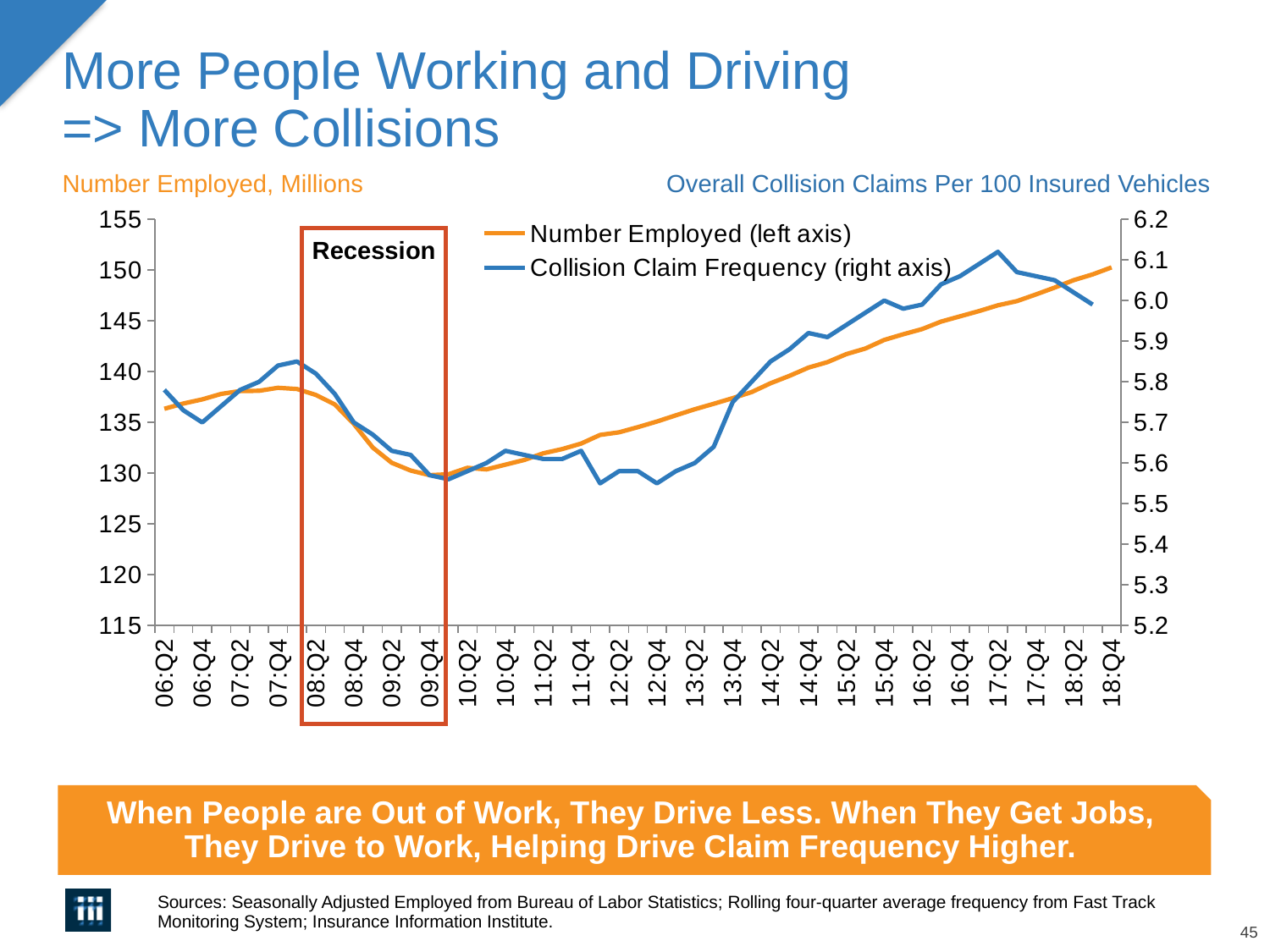
Does the Number Employed series rise or fall from 10:Q2 to 18:Q4? Rise At which quarter does the Collision Claim Frequency series reach its highest value? 17:Q2 Is the value for Number Employed at 09:Q4 greater or less than 135? less Is the value for Number Employed at 06:Q2 greater or less than 140? less Is the value for Collision Claim Frequency at 12:Q4 greater or less than 5.6? less What kind of chart is shown on the slide? Line chart How many series does the legend list? 2 At which quarter does the Number Employed series reach its highest value? 18:Q4 Which series is plotted against the left axis? Number Employed What label is shown inside the red box on the chart? Recession